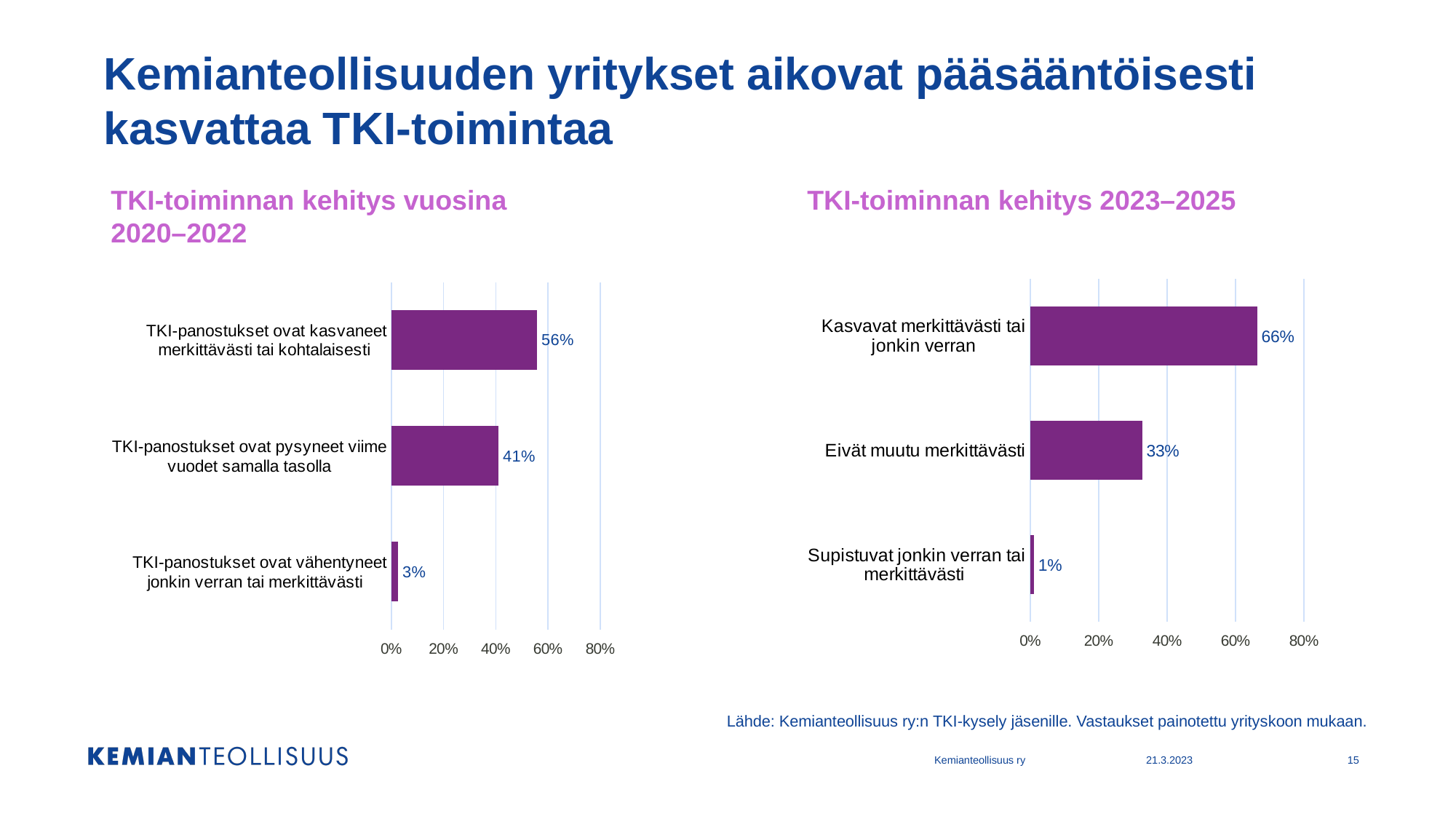
What kind of chart is the right chart (TKI-toiminnan kehitys 2023–2025)? bar chart In the left chart (TKI-toiminnan kehitys vuosina 2020–2022), which category has the lowest value? TKI-panostukset ovat vähentyneet jonkin verran tai merkittävästi In the right chart (TKI-toiminnan kehitys 2023–2025), what is the value for 'Supistuvat jonkin verran tai merkittävästi'? 1% In the left chart (TKI-toiminnan kehitys vuosina 2020–2022), what is the value for 'TKI-panostukset ovat pysyneet viime vuodet samalla tasolla'? 41% How many categories does the left chart (TKI-toiminnan kehitys vuosina 2020–2022) show? 3 In the left chart (TKI-toiminnan kehitys vuosina 2020–2022), what is the difference between the values for 'TKI-panostukset ovat kasvaneet merkittävästi tai kohtalaisesti' and 'TKI-panostukset ovat pysyneet viime vuodet samalla tasolla'? 15% In the left chart (TKI-toiminnan kehitys vuosina 2020–2022), what is the value for 'TKI-panostukset ovat kasvaneet merkittävästi tai kohtalaisesti'? 56% In the right chart (TKI-toiminnan kehitys 2023–2025), which category has the highest value? Kasvavat merkittävästi tai jonkin verran In the right chart (TKI-toiminnan kehitys 2023–2025), what is the difference between the values for 'Kasvavat merkittävästi tai jonkin verran' and 'Eivät muutu merkittävästi'? 33% Which is larger: the value for 'Kasvavat merkittävästi tai jonkin verran' in the right chart or the value for 'TKI-panostukset ovat kasvaneet merkittävästi tai kohtalaisesti' in the left chart? Kasvavat merkittävästi tai jonkin verran (right chart) In the right chart (TKI-toiminnan kehitys 2023–2025), what is the value for 'Eivät muutu merkittävästi'? 33% In the right chart (TKI-toiminnan kehitys 2023–2025), is the value for 'Kasvavat merkittävästi tai jonkin verran' greater or less than 60%? greater